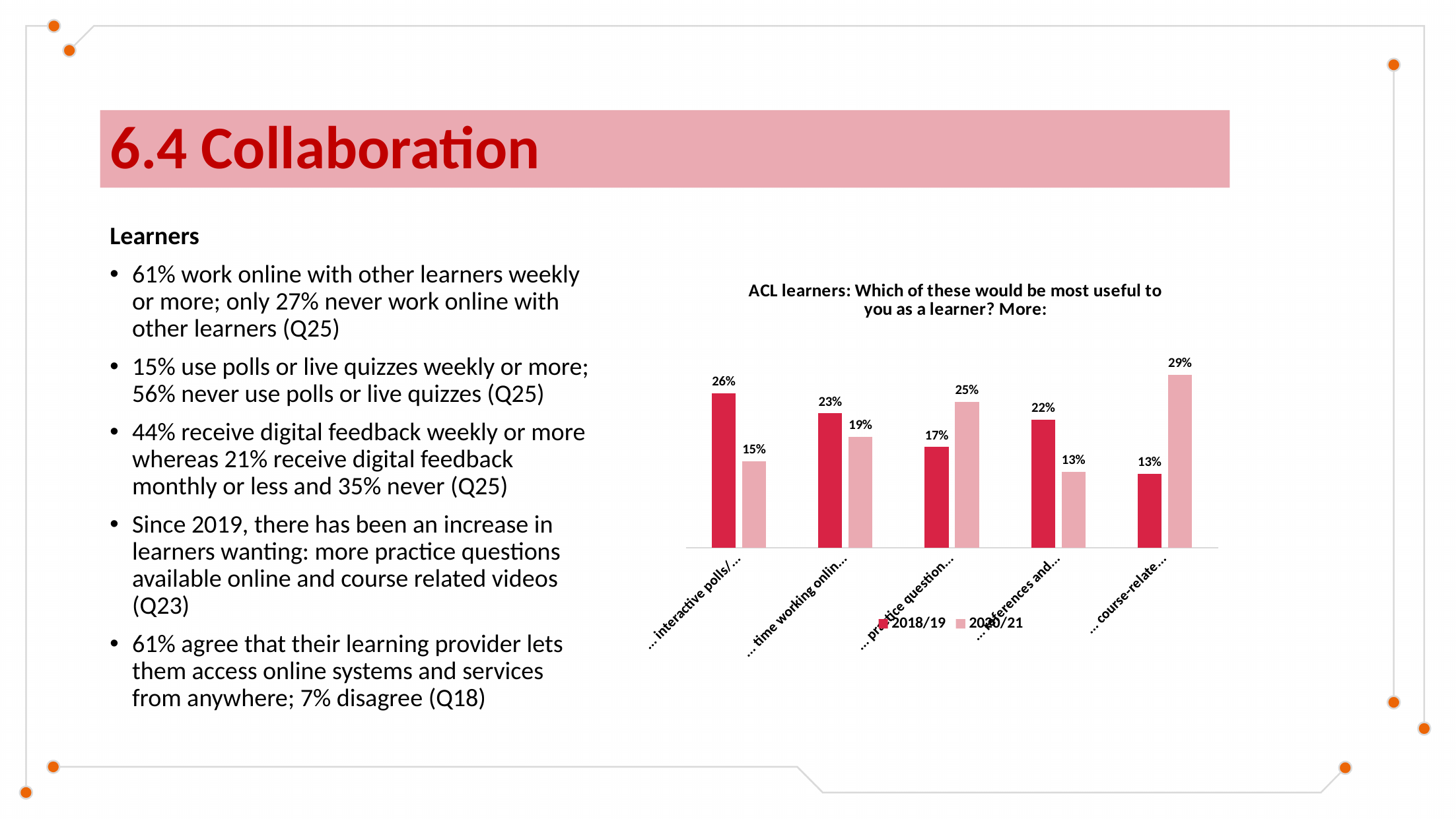
What is the 2020/21 value for the 'course-related' category? 29% Which category has the highest 2018/19 value? interactive polls Which category has the lowest 2020/21 value? references and readings What is the 2018/19 value for the 'interactive polls' category? 26% How many series does the chart legend list? 2 What type of chart is shown on the slide? bar chart What is the difference between the 2020/21 and 2018/19 values for the 'course-related' category? 16% How many categories are shown on the x axis of the chart? 5 For the 'time working online' category, which series has the larger value, 2018/19 or 2020/21? 2018/19 What is the 2020/21 value for the 'practice questions' category? 25% What are the two series named in the chart legend? 2018/19 and 2020/21